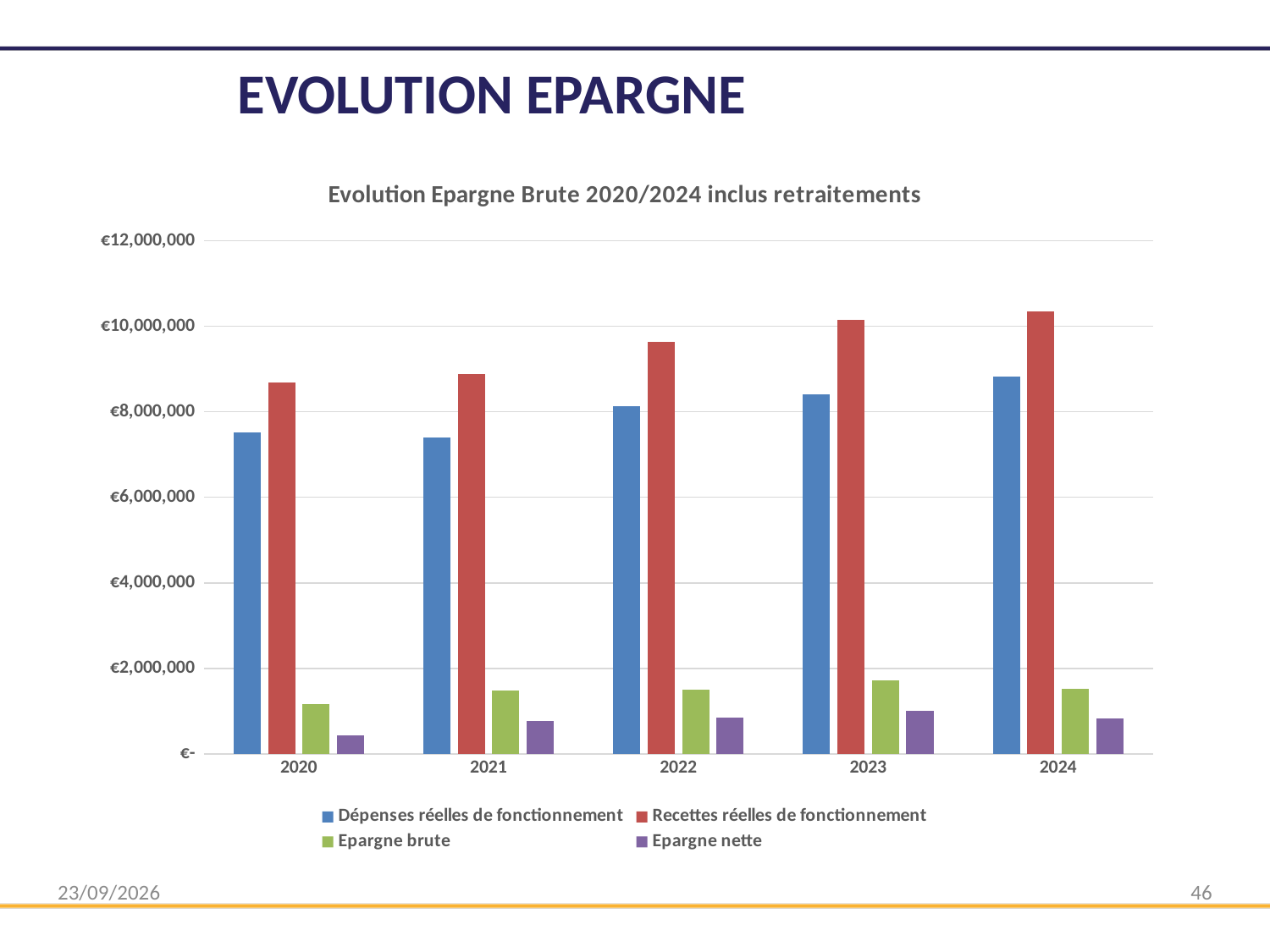
In which year is Epargne nette lowest? 2020 What kind of chart is shown on the slide? bar chart Is the value for Dépenses réelles de fonctionnement in 2020 greater or less than €8,000,000? less In which year is Epargne brute highest? 2023 In which year is Recettes réelles de fonctionnement highest? 2024 In 2022, which is larger: Recettes réelles de fonctionnement or Dépenses réelles de fonctionnement? Recettes réelles de fonctionnement Do the values for Recettes réelles de fonctionnement rise or fall from 2020 to 2024? rise Is the value for Recettes réelles de fonctionnement in 2023 greater or less than €10,000,000? greater How many series does the legend list? 4 How many years are shown on the x axis? 5 Is the value for Epargne brute in 2023 greater or less than €2,000,000? less What is the title of the chart? Evolution Epargne Brute 2020/2024 inclus retraitements